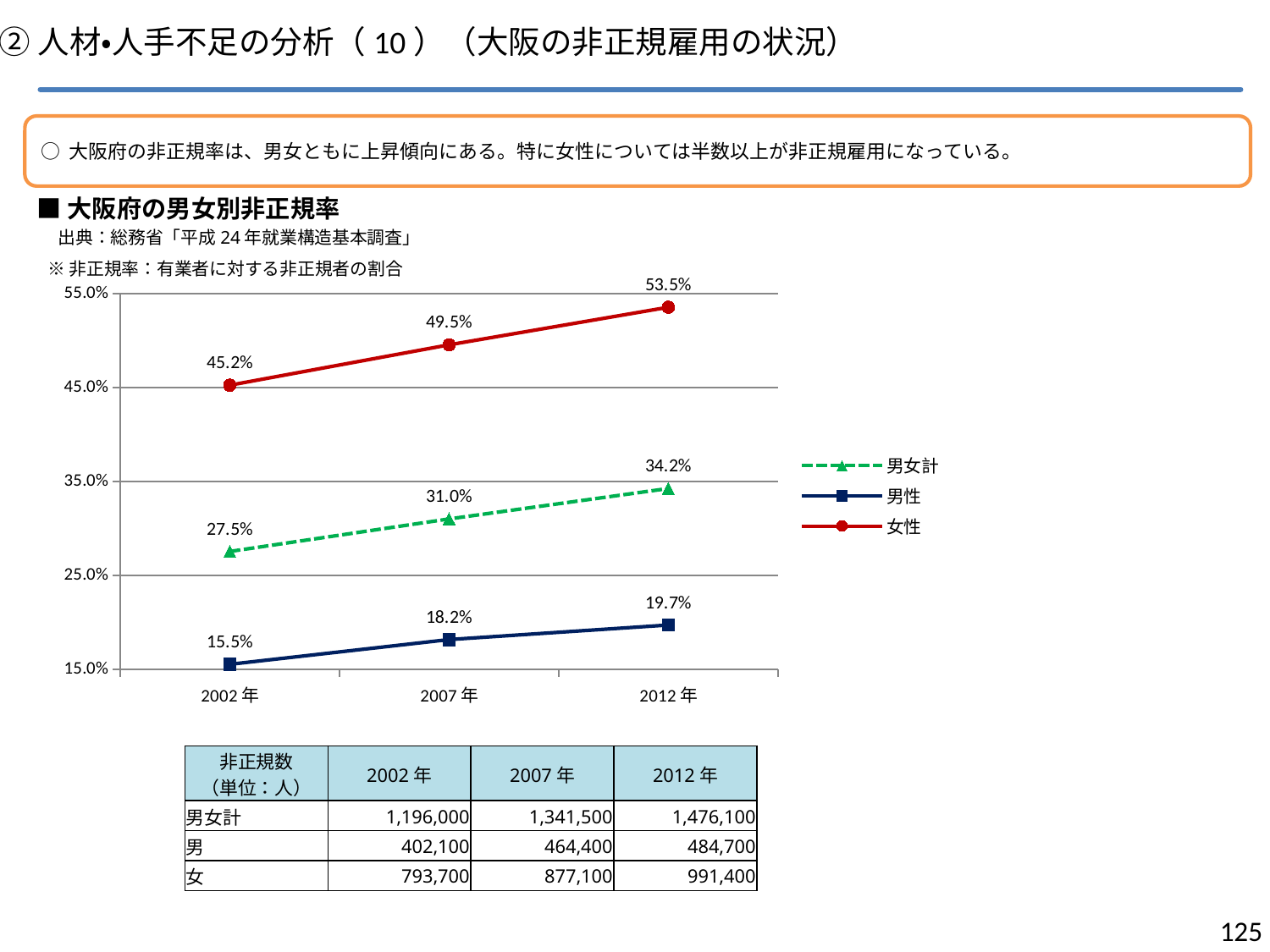
How many years are shown on the x axis? 3 Which is larger, the 男女計 value in 2012年 or the 女性 value in 2002年? 女性 in 2002年 What is the value for 男性 in 2002年? 15.5% Does the 男性 series rise or fall from 2002年 to 2012年? rise What type of chart is shown on the slide? line chart How many series does the legend list? 3 Which series has the highest value in 2012年? 女性 What is the value for 男女計 in 2007年? 31.0% What is the value for 女性 in 2012年? 53.5% Which series is drawn with a dashed line? 男女計 What is the difference between the 女性 value and the 男性 value in 2012年? 33.8% Which series has the lowest value in 2002年? 男性